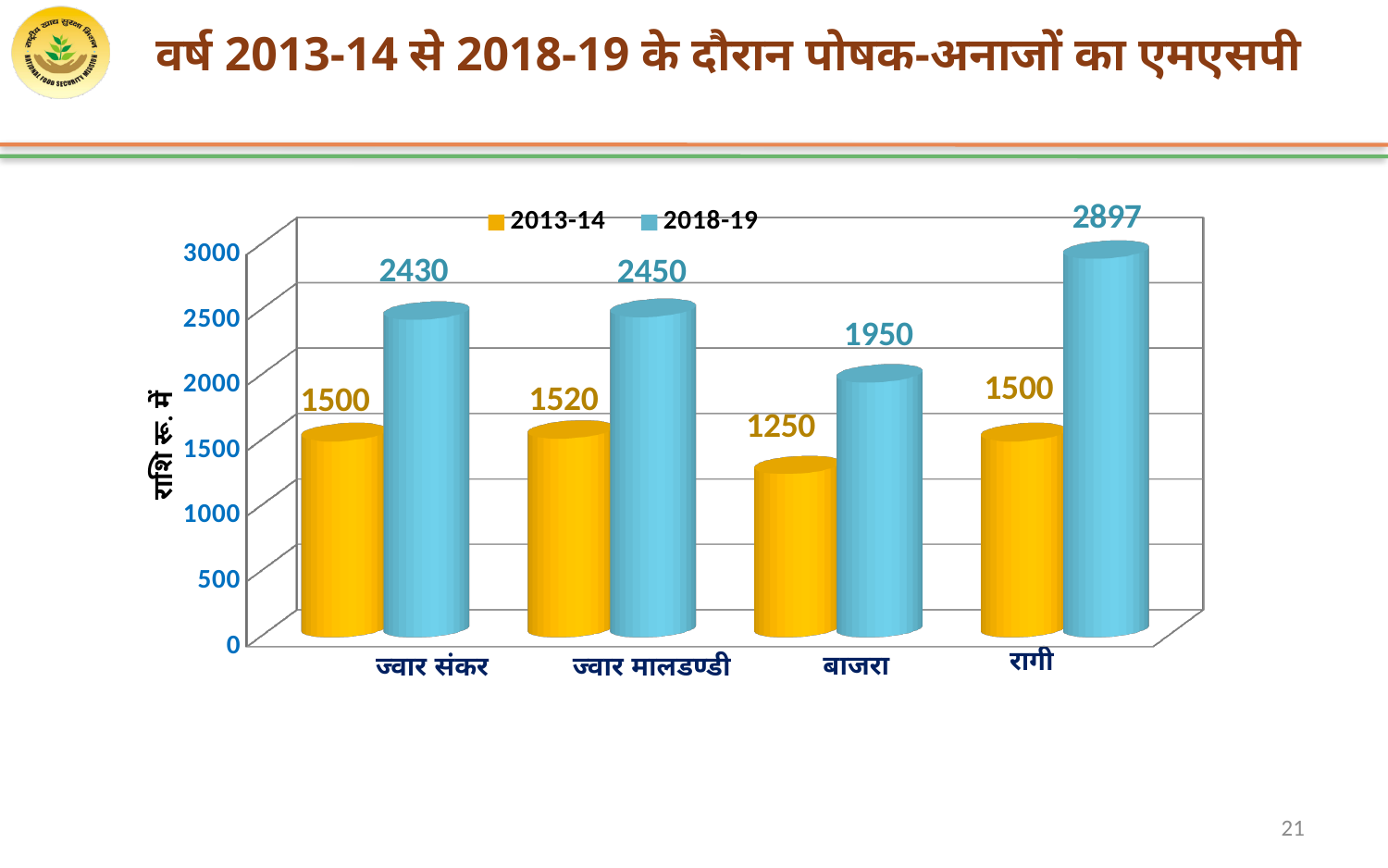
How many categories are shown on the x axis? 4 What is the difference between the 2018-19 values for रागी and बाजरा? 947 What is the 2018-19 value for ज्वार मालडण्डी? 2450 Is the 2018-19 value for बाजरा greater or less than 2000? less What is the 2018-19 value for रागी? 2897 What is the 2013-14 value for बाजरा? 1250 Which category has the highest 2018-19 value? रागी What kind of chart is shown on the slide? bar chart Which category has the lowest 2013-14 value? बाजरा Which is larger: the 2013-14 value for ज्वार मालडण्डी or the 2013-14 value for ज्वार संकर? ज्वार मालडण्डी How many series does the legend list? 2 What is the difference between the 2018-19 and 2013-14 values for ज्वार संकर? 930